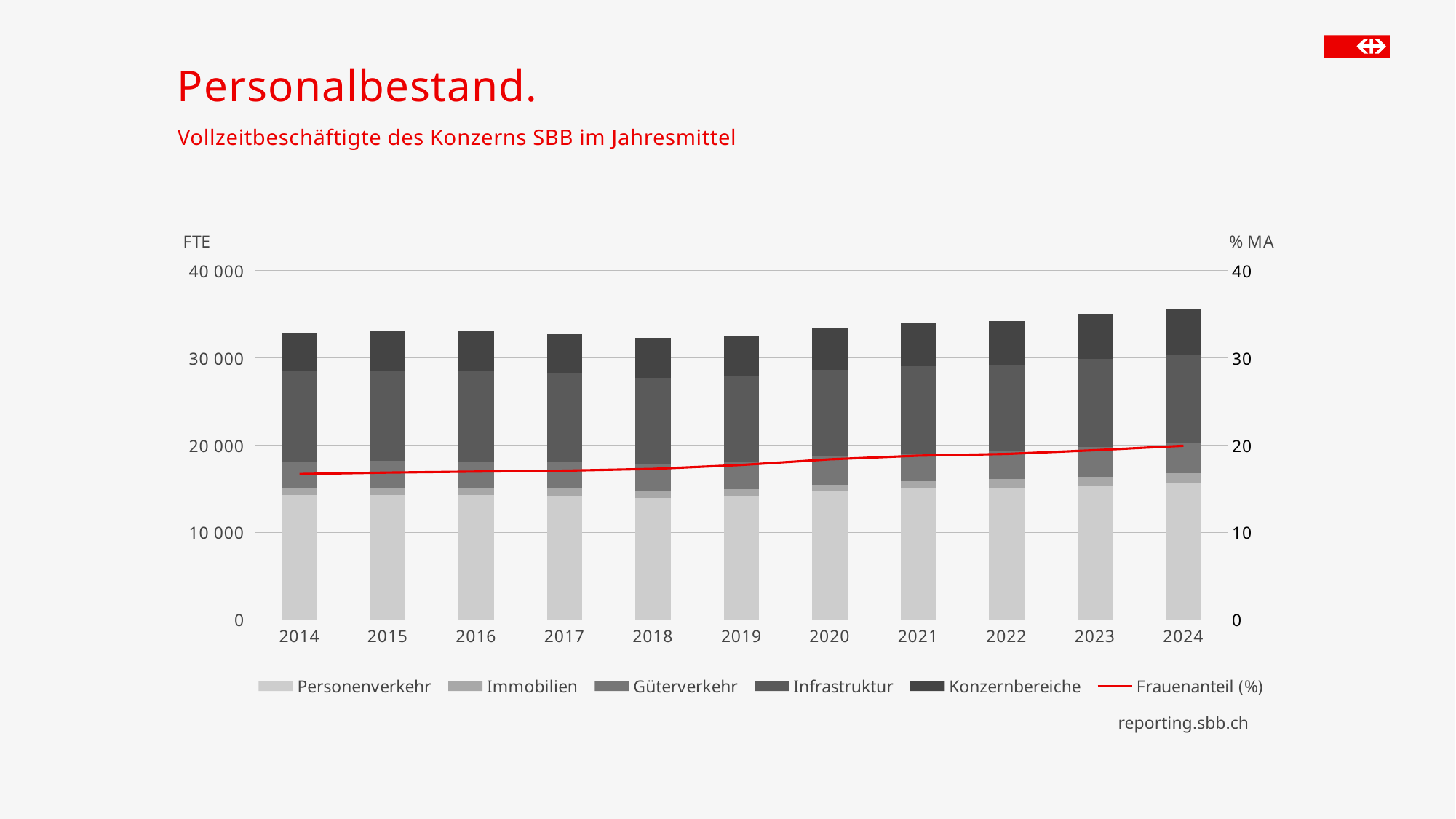
What unit label is shown on the right-hand axis? % MA Does the Frauenanteil (%) line rise or fall from 2014 to 2024? rises How many series does the legend list? 6 What is the title of the chart slide? Personalbestand. Is the total FTE bar for 2024 greater or less than 30 000? greater Which year has the larger total FTE bar, 2014 or 2024? 2024 Is the Personenverkehr segment for 2014 greater or less than 10 000 FTE? greater Is the Frauenanteil (%) value for 2014 greater or less than 20? less Which year has the highest total FTE bar? 2024 How many years are shown on the x axis? 11 What kind of chart is shown on the slide? stacked bar chart with a line